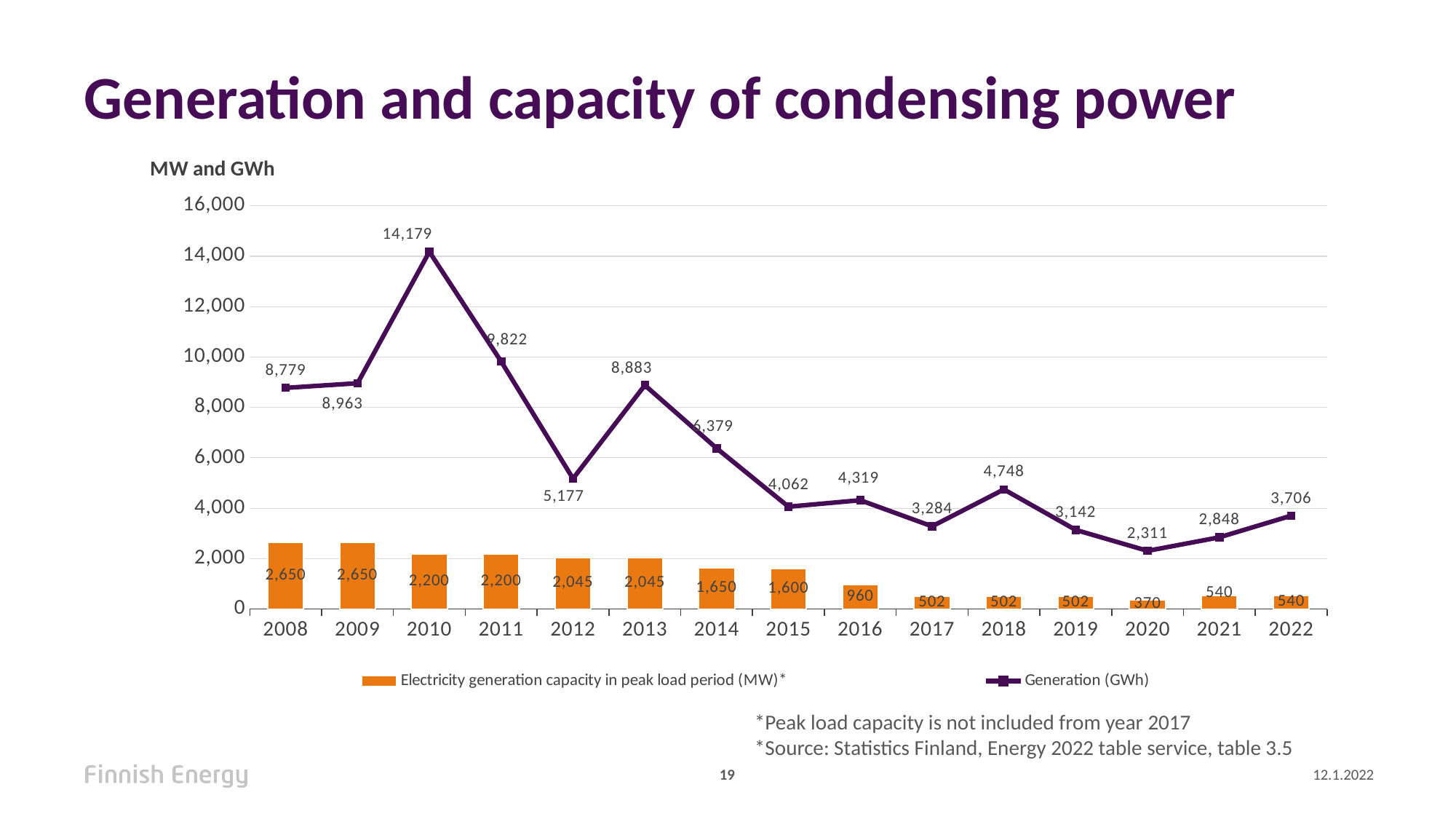
What is the difference between generation (GWh) in 2010 and 2011? 4,357 In which year was generation (GWh) highest? 2010 How many years are shown on the x axis? 15 Which year had higher generation (GWh), 2013 or 2014? 2013 What kind of chart is used to show the electricity generation capacity in peak load period (MW)? Bar chart What is the title of the chart? Generation and capacity of condensing power What was the generation (GWh) in 2010? 14,179 What was the electricity generation capacity in peak load period (MW) in 2016? 960 In which year was the electricity generation capacity in peak load period (MW) lowest? 2020 In which year was generation (GWh) lowest? 2020 Does the electricity generation capacity in peak load period (MW) generally rise or fall from 2008 to 2020? Fall How many series does the legend list? 2